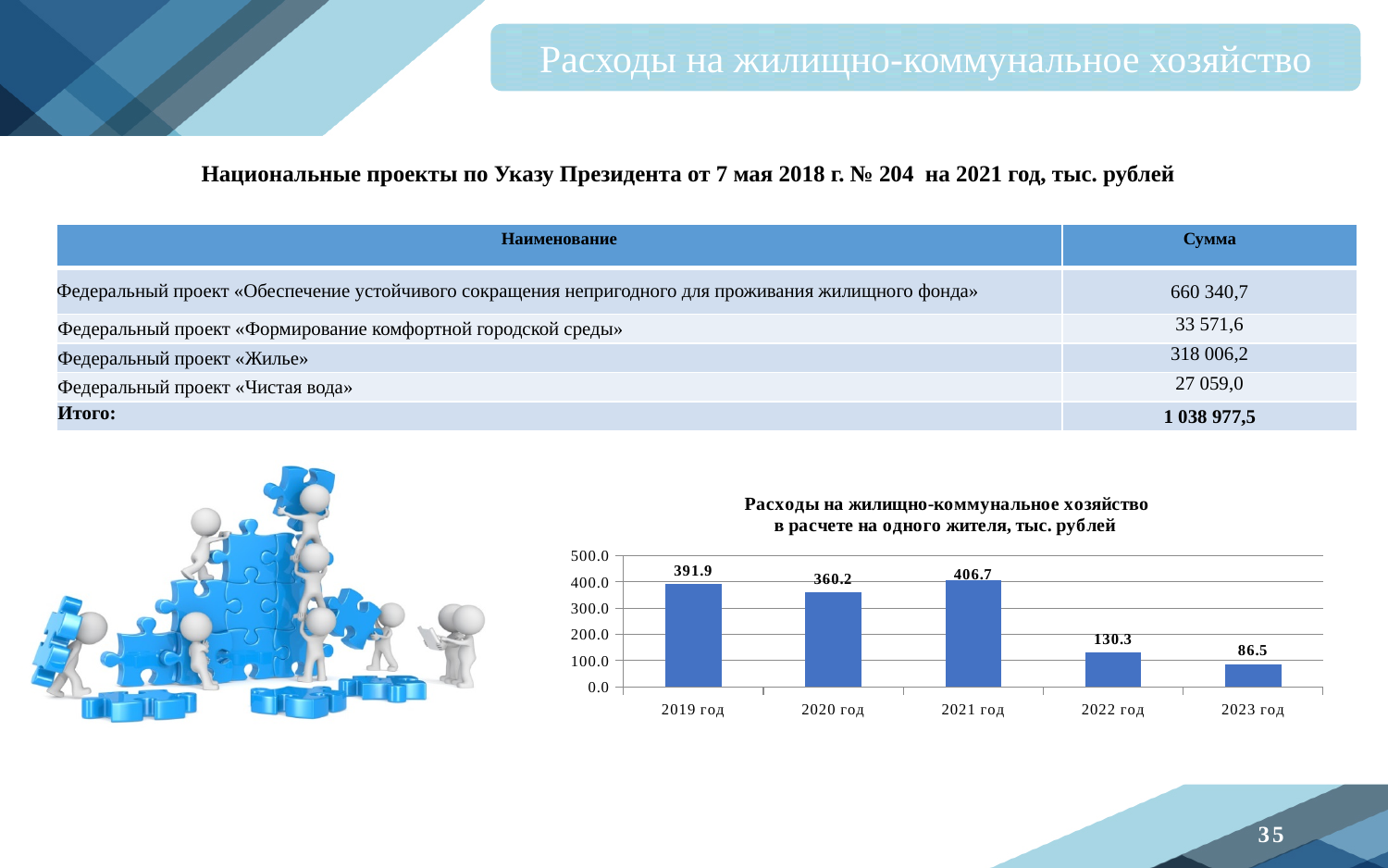
What is the difference between the values for 2022 год and 2023 год? 43.8 What is the value for 2023 год in the chart? 86.5 What kind of chart is shown on the slide? bar chart What is the value for 2022 год in the chart? 130.3 What is the title of the chart? Расходы на жилищно-коммунальное хозяйство в расчете на одного жителя, тыс. рублей How many years are shown on the x axis of the chart? 5 Which is larger, the value for 2019 год or the value for 2020 год? 2019 год What is the difference between the values for 2021 год and 2020 год? 46.5 Which year has the lowest value in the chart? 2023 год Is the value for 2022 год greater or less than 200.0? less What is the value for 2019 год in the chart? 391.9 Which year has the highest value in the chart? 2021 год